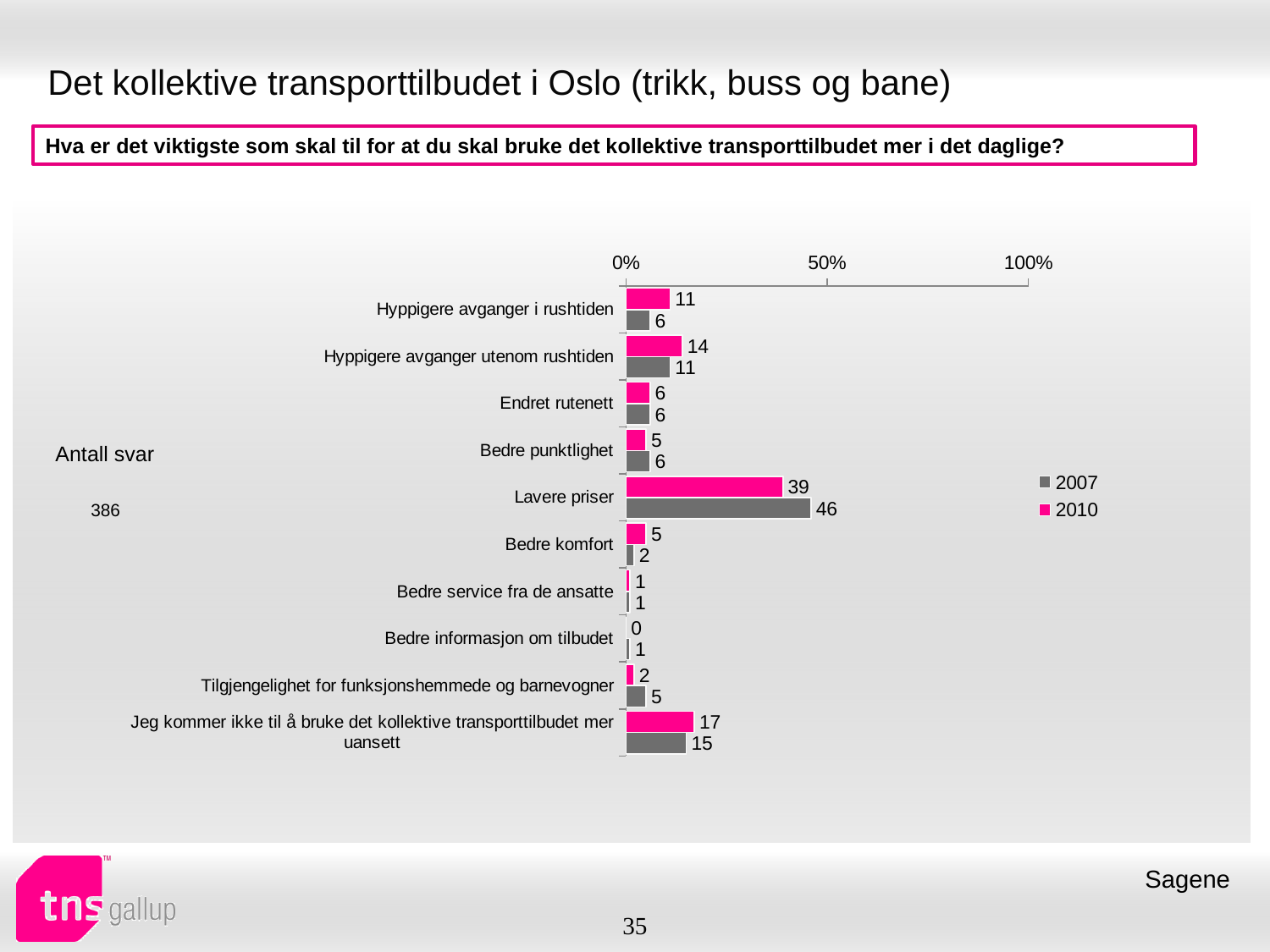
Which is larger for Hyppigere avganger i rushtiden: the 2007 value or the 2010 value? 2010 How many series does the legend list? 2 Which category has the highest 2007 value? Lavere priser What is the 2007 value for Hyppigere avganger utenom rushtiden? 11 Which colour represents the 2010 series in the legend? pink What is the 2010 value for Lavere priser? 39 Which category has the lowest 2010 value? Bedre informasjon om tilbudet What is the difference between the 2007 and 2010 values for Lavere priser? 7 Is the 2007 value for Lavere priser greater or less than 50%? less What kind of chart is shown on the slide? bar chart How many categories are shown on the chart? 10 What is the 2010 value for Jeg kommer ikke til å bruke det kollektive transporttilbudet mer uansett? 17